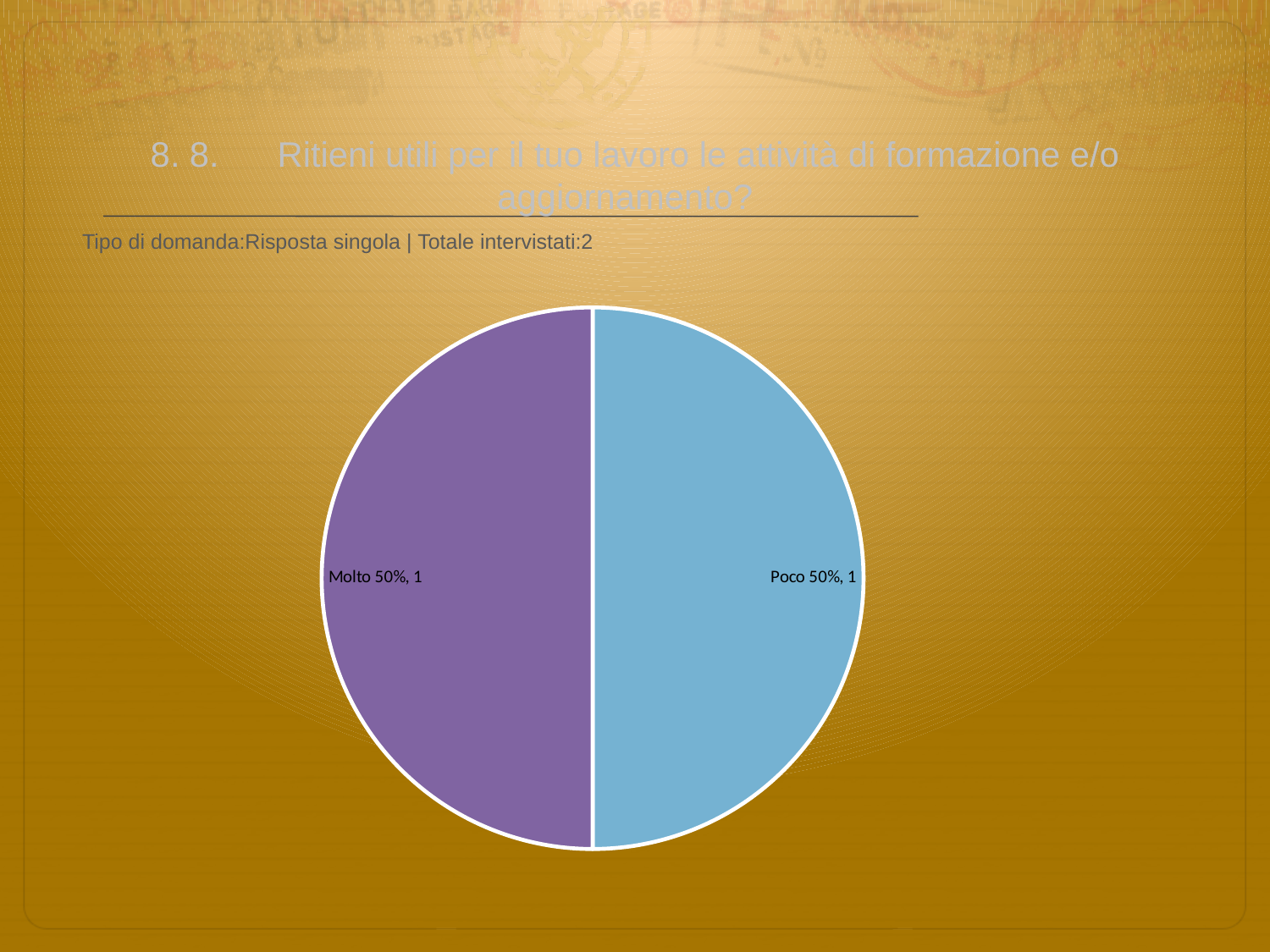
What percentage share does the Molto slice have? 50% Is the share for Poco greater or less than 25%? greater What is the count value shown for the Molto slice? 1 How many slices does the pie chart have? 2 What colour is the Poco slice? light blue What kind of chart is shown on the slide? pie chart What colour is the Molto slice? purple What is the total of the values for Molto and Poco? 2 What is the difference between the values for Molto and Poco? 0 What percentage share does the Poco slice have? 50% What is the count value shown for the Poco slice? 1